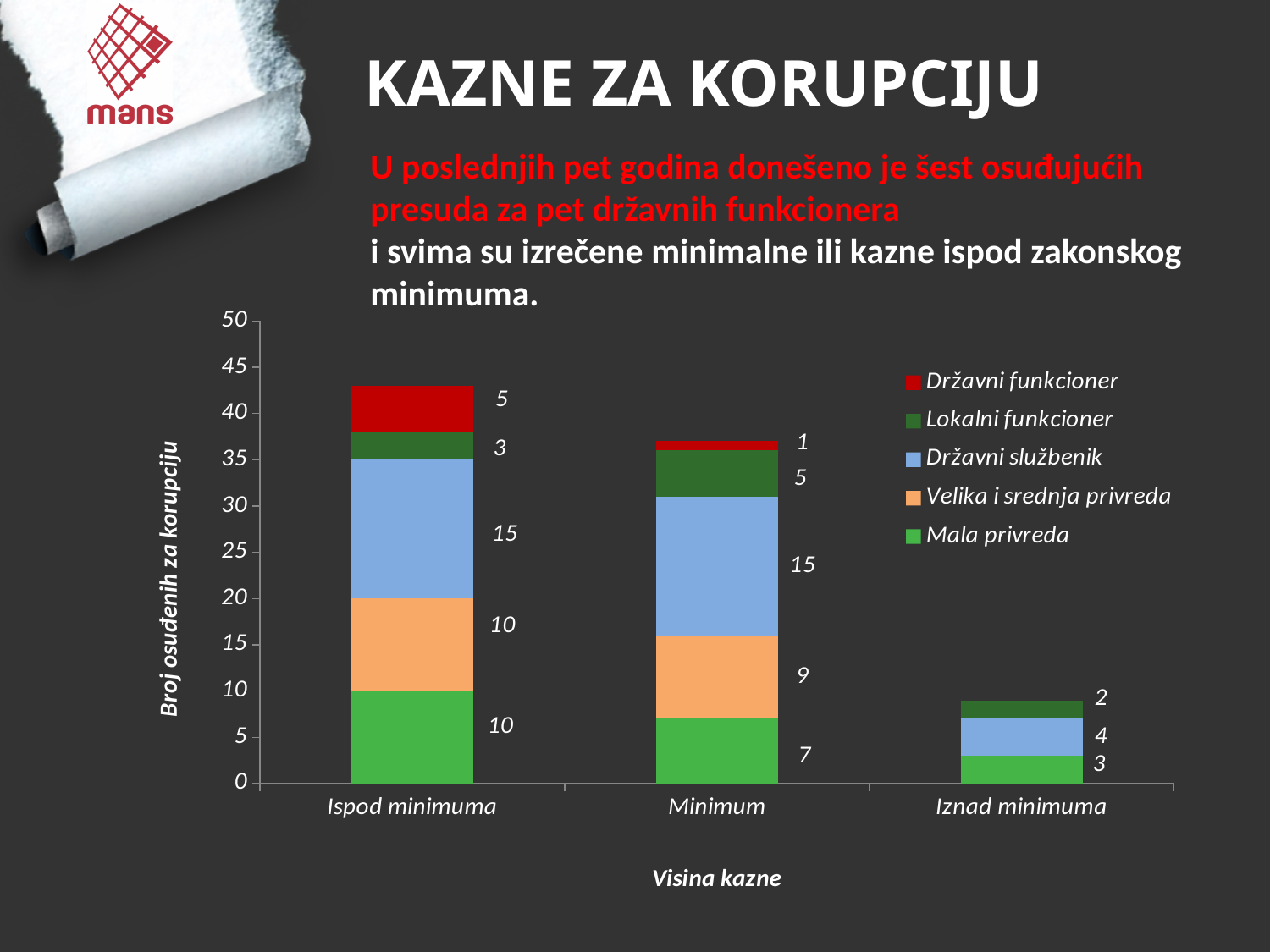
How many categories are shown on the x axis? 3 What is the total of the Iznad minimuma stacked bar? 9 What is the value for Lokalni funkcioner in the Iznad minimuma bar? 2 What is the difference between the Velika i srednja privreda values for Ispod minimuma and Minimum? 1 What is the value for Mala privreda in the Minimum bar? 7 Which category has the lowest total bar? Iznad minimuma How many series does the legend list? 5 What is the total of the Ispod minimuma stacked bar? 43 What is the label of the y axis? Broj osuđenih za korupciju What is the value for Državni funkcioner in the Minimum bar? 1 What is the value for Državni službenik in the Ispod minimuma bar? 15 What kind of chart is shown on the slide? stacked bar chart